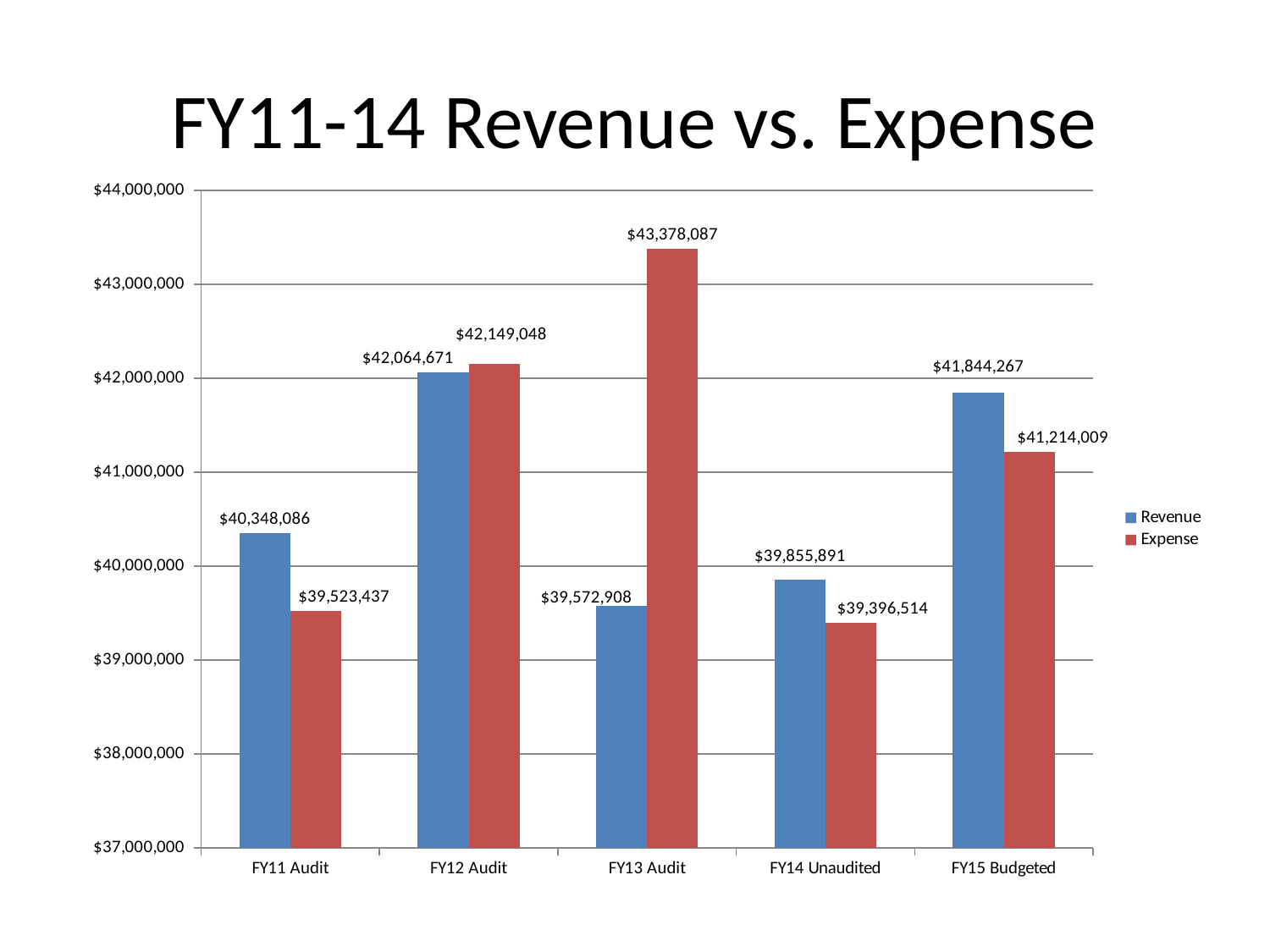
What kind of chart is shown on the slide? Bar chart Which category has the lowest Revenue value? FY13 Audit Which is larger for FY15 Budgeted, Revenue or Expense? Revenue What is the difference between Revenue and Expense for FY11 Audit? $824,649 How many series does the legend list? 2 What is the difference between Expense and Revenue for FY13 Audit? $3,805,179 What is the Revenue value for FY14 Unaudited? $39,855,891 How many categories are shown on the x axis? 5 What is the Expense value for FY15 Budgeted? $41,214,009 Which category has the lowest Expense value? FY14 Unaudited What is the Revenue value for FY13 Audit? $39,572,908 Which category has the highest Expense value? FY13 Audit